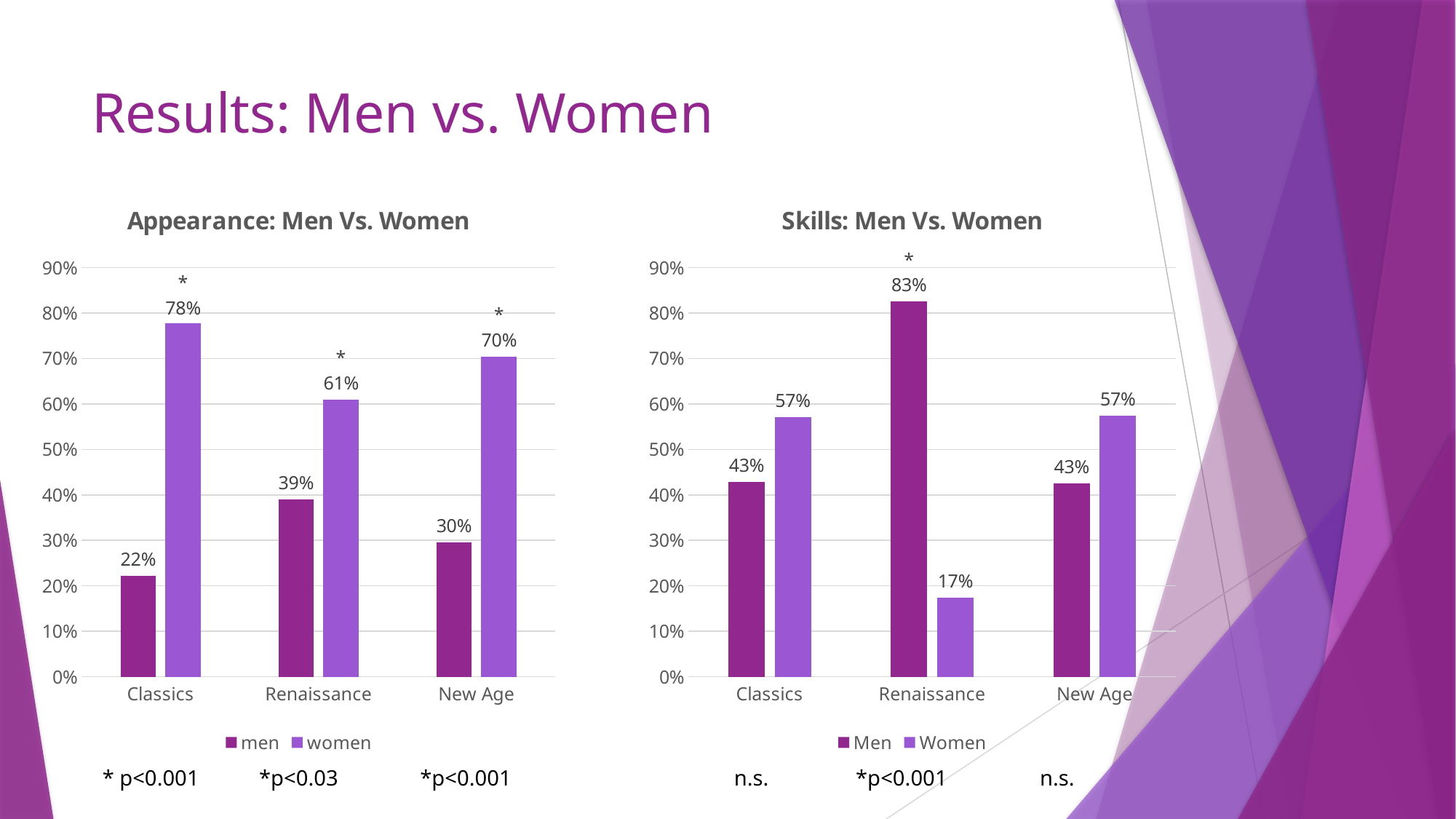
What type of chart is the 'Appearance: Men Vs. Women' chart? Bar chart How many categories are shown on the x axis of the 'Appearance: Men Vs. Women' chart? 3 In the 'Appearance: Men Vs. Women' chart, what is the difference between the women and men values for Renaissance? 22% How many series does the legend of the 'Skills: Men Vs. Women' chart list? 2 In the 'Appearance: Men Vs. Women' chart, which category has the lowest value for men? Classics In the 'Appearance: Men Vs. Women' chart, what is the value for men in the New Age category? 30% In the 'Skills: Men Vs. Women' chart, which category has the highest value for Men? Renaissance In the 'Skills: Men Vs. Women' chart, what is the difference between the Men and Women values for Renaissance? 66% In the 'Skills: Men Vs. Women' chart, what is the value for Men in the Renaissance category? 83% In the 'Skills: Men Vs. Women' chart, which is larger for Classics: the Men value or the Women value? Women In the 'Skills: Men Vs. Women' chart, what is the value for Women in the Renaissance category? 17% In the 'Appearance: Men Vs. Women' chart, what is the value for women in the Classics category? 78%